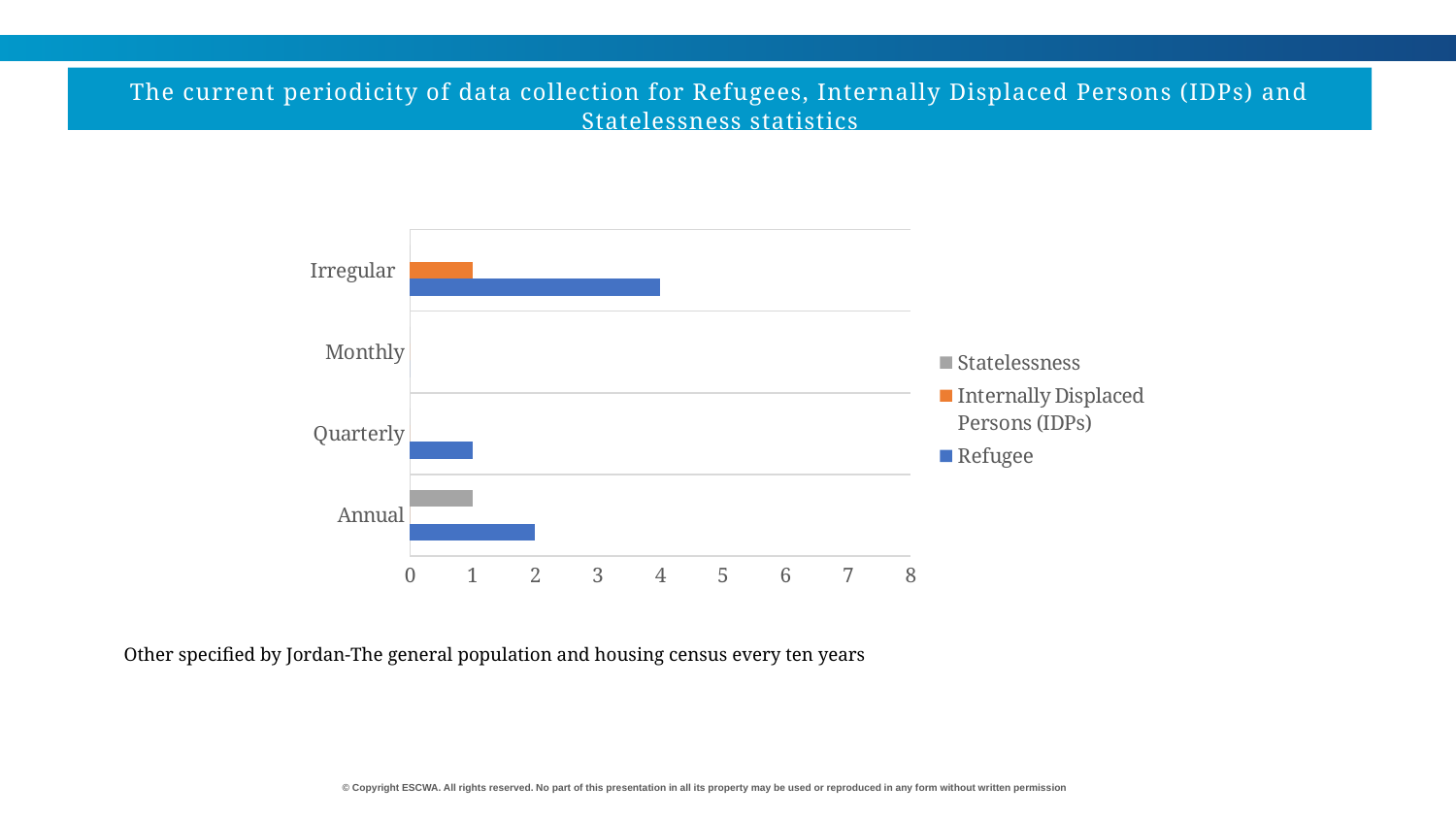
Which series is shown in orange in the legend? Internally Displaced Persons (IDPs) What is the difference between the Refugee values for Irregular and Annual? 2 What kind of chart is shown on the slide? bar chart What is the value for Refugee in the Annual category? 2 How many series does the legend list? 3 Which category has the highest Refugee value? Irregular How many categories are shown on the vertical axis? 4 What is the value for Refugee in the Irregular category? 4 Which is larger in the Irregular category: the Refugee value or the Internally Displaced Persons (IDPs) value? Refugee What is the value for Statelessness in the Annual category? 1 What is the value for Refugee in the Quarterly category? 1 What is the value for Internally Displaced Persons (IDPs) in the Irregular category? 1